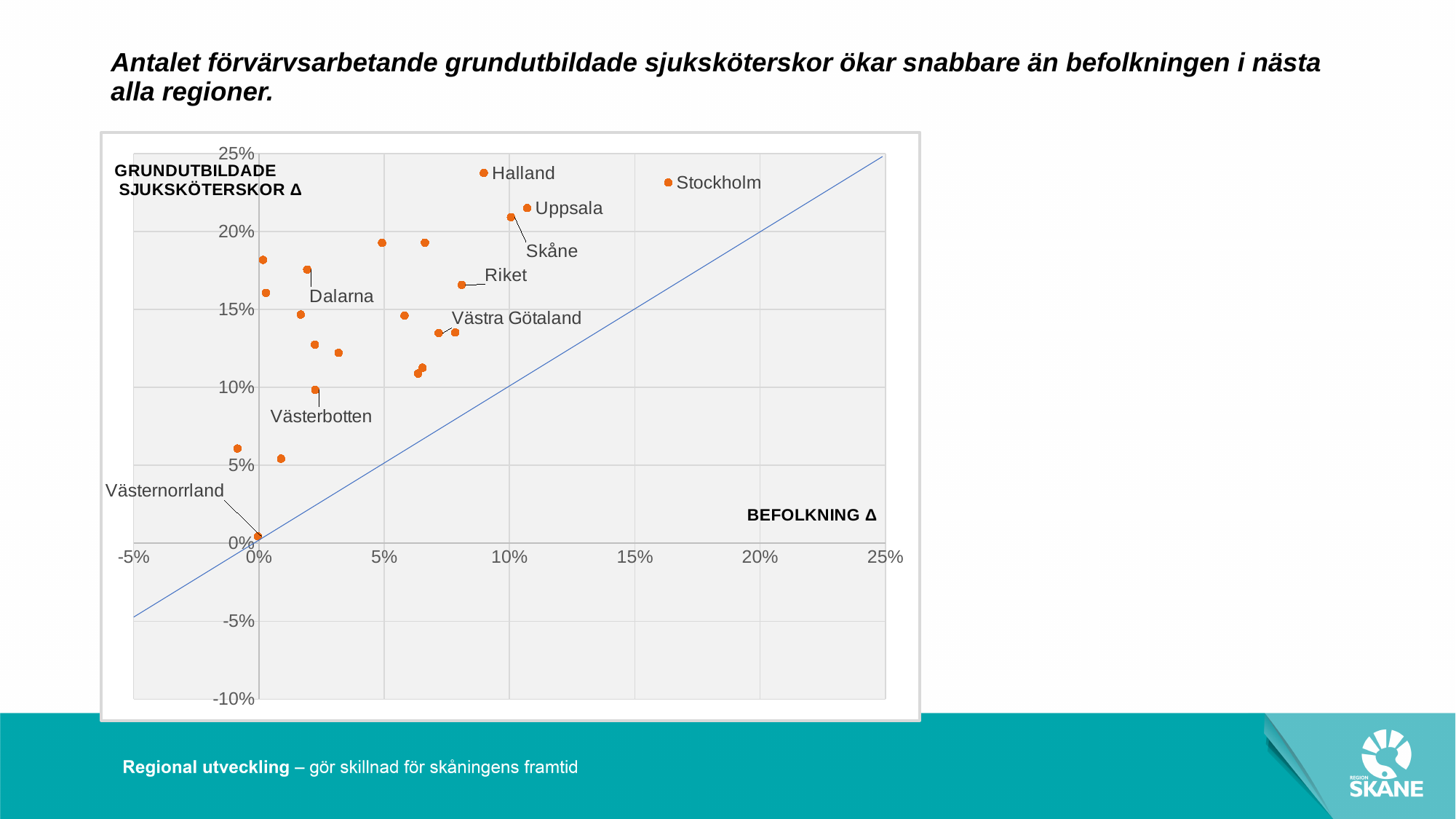
What kind of chart is shown on the slide? Scatter chart Is the GRUNDUTBILDADE SJUKSKÖTERSKOR Δ value for Halland greater or less than 20%? greater Is the GRUNDUTBILDADE SJUKSKÖTERSKOR Δ value for Västerbotten greater or less than 15%? less What is the label of the horizontal axis of the chart? BEFOLKNING Δ Is the BEFOLKNING Δ value for Stockholm greater or less than 15%? greater Which has the higher BEFOLKNING Δ, Stockholm or Skåne? Stockholm Which has the higher GRUNDUTBILDADE SJUKSKÖTERSKOR Δ, Dalarna or Västerbotten? Dalarna Which has the higher GRUNDUTBILDADE SJUKSKÖTERSKOR Δ, Uppsala or Riket? Uppsala Which labelled region has the lowest GRUNDUTBILDADE SJUKSKÖTERSKOR Δ (y-axis value)? Västernorrland Which labelled region has the highest BEFOLKNING Δ (x-axis value)? Stockholm